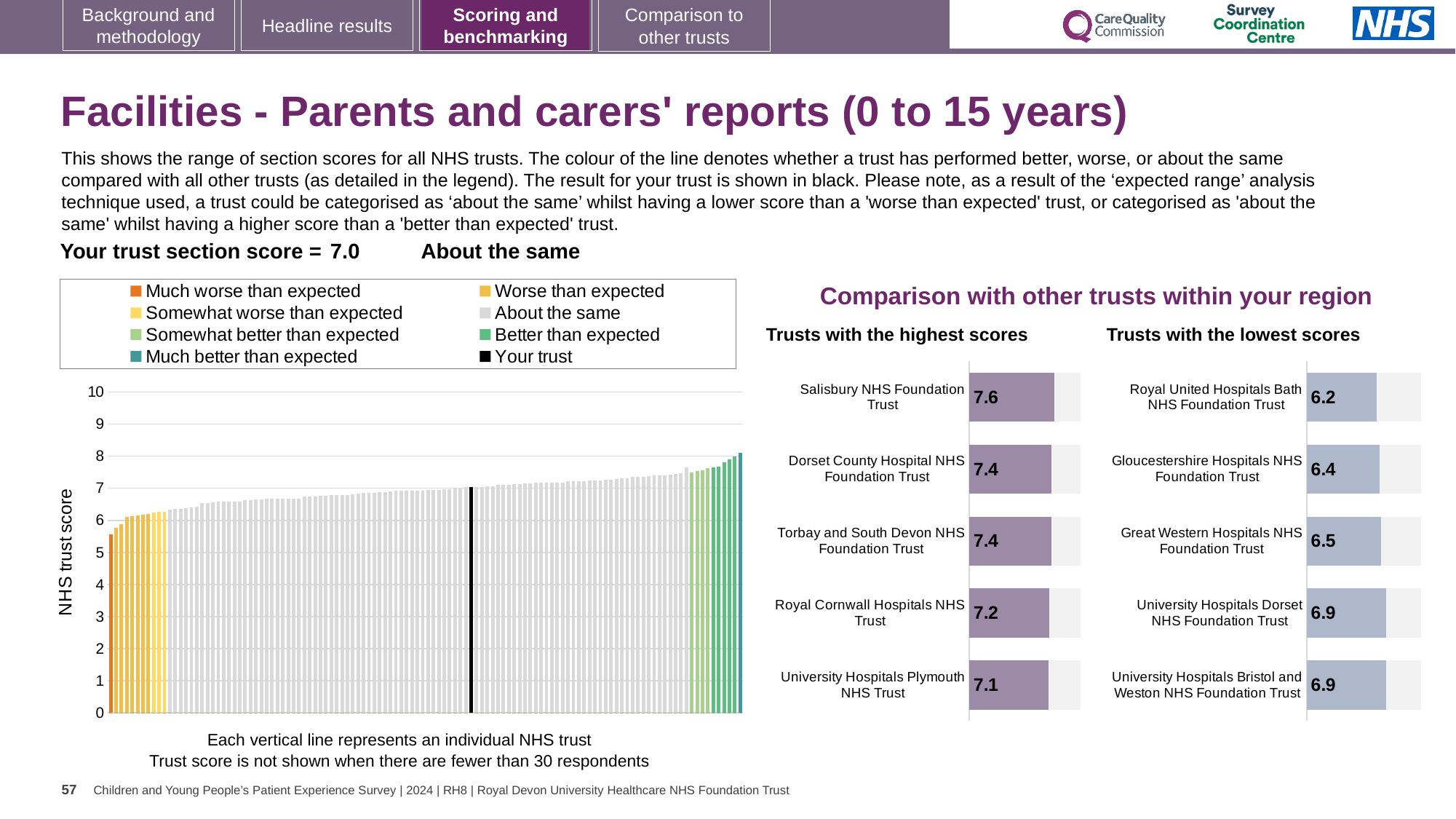
In the large chart on the left, is the value of the leftmost (orange) bar greater or less than 6? less In the 'Trusts with the lowest scores' chart, which trust has the lowest score? Royal United Hospitals Bath NHS Foundation Trust In the 'Trusts with the highest scores' chart, what is the score for Salisbury NHS Foundation Trust? 7.6 In the 'Trusts with the highest scores' chart, which trust has the highest score? Salisbury NHS Foundation Trust How many trusts are shown in the 'Trusts with the highest scores' chart? 5 In the 'Trusts with the lowest scores' chart, which has the higher score: Gloucestershire Hospitals NHS Foundation Trust or Great Western Hospitals NHS Foundation Trust? Great Western Hospitals NHS Foundation Trust In the large chart on the left, is the value for the black 'Your trust' bar greater or less than 5? greater What kind of chart is the large chart on the left showing NHS trust scores? Bar chart In the 'Trusts with the highest scores' chart, what is the difference between the scores of Salisbury NHS Foundation Trust and University Hospitals Plymouth NHS Trust? 0.5 In the 'Trusts with the lowest scores' chart, what is the difference between the scores of Great Western Hospitals NHS Foundation Trust and Royal United Hospitals Bath NHS Foundation Trust? 0.3 How many entries does the legend of the large chart on the left list? 8 In the 'Trusts with the lowest scores' chart, what is the score for Gloucestershire Hospitals NHS Foundation Trust? 6.4